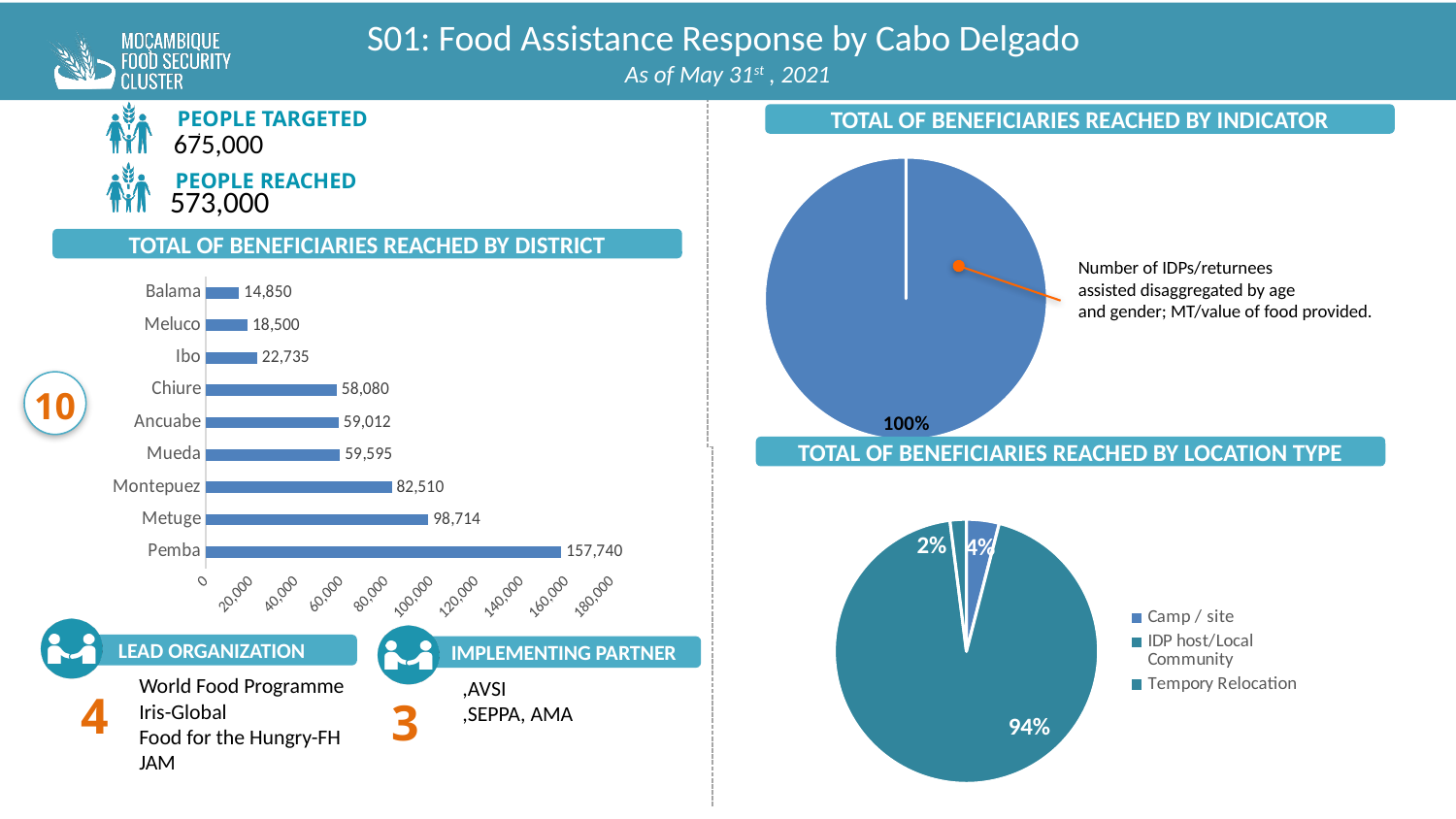
What kind of chart is 'Total of beneficiaries reached by district'? Bar chart How many districts are shown in the 'Total of beneficiaries reached by district' chart? 9 In the 'Total of beneficiaries reached by district' chart, what is the value for Montepuez? 82,510 In the 'Total of beneficiaries reached by district' chart, what is the difference between Pemba and Metuge? 59,026 In the 'Total of beneficiaries reached by district' chart, which is larger, Ibo or Chiure? Chiure In the 'Total of beneficiaries reached by district' chart, which district has the lowest value? Balama In the 'Total of beneficiaries reached by district' chart, what is the value for Pemba? 157,740 In the 'Total of beneficiaries reached by location type' chart, what share does Camp / site have? 4% How many entries does the legend of the 'Total of beneficiaries reached by location type' chart list? 3 In the 'Total of beneficiaries reached by district' chart, which district has the highest value? Pemba In the 'Total of beneficiaries reached by district' chart, what is the difference between Meluco and Balama? 3,650 In the 'Total of beneficiaries reached by location type' chart, what share does the largest slice have? 94%